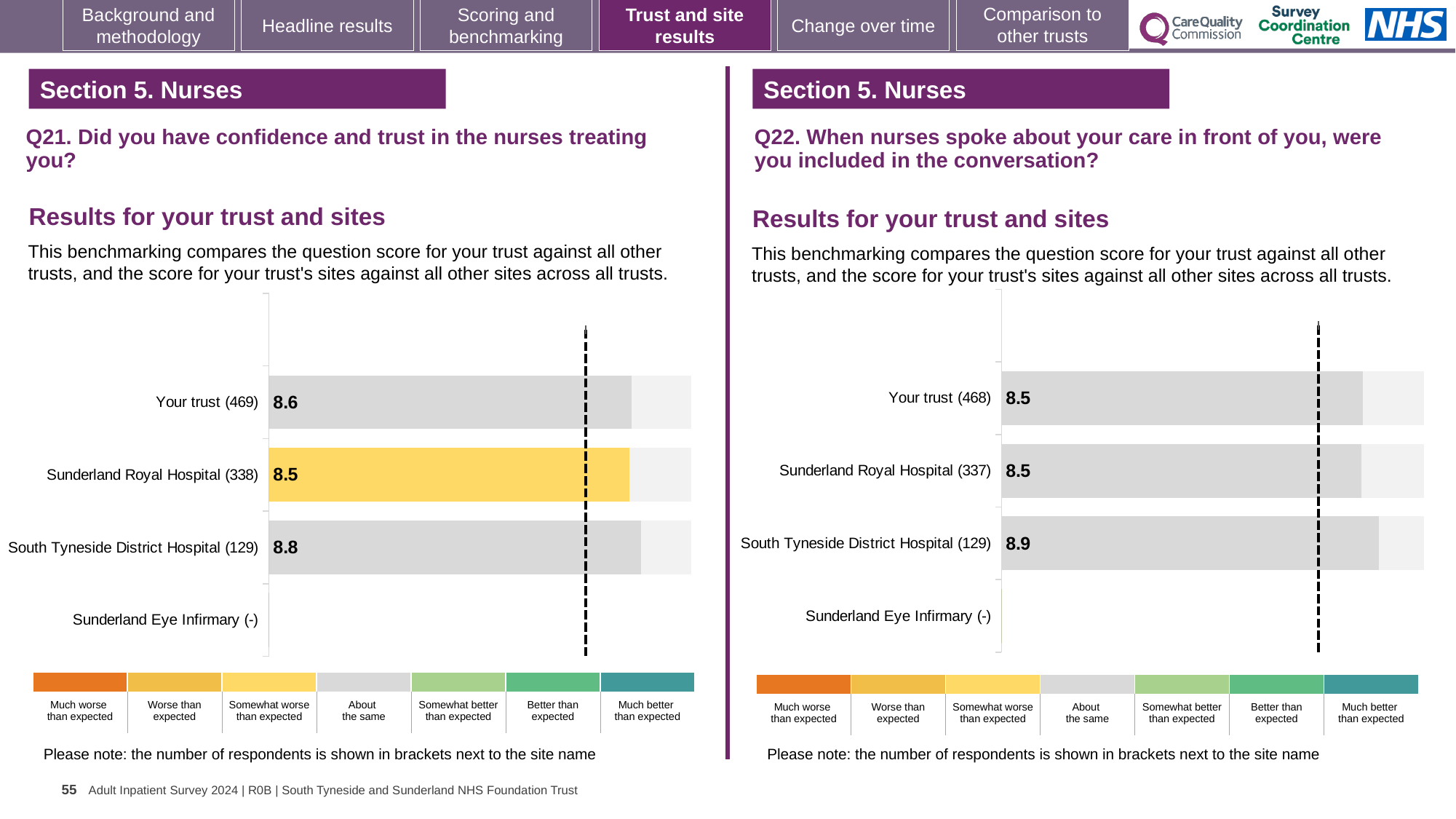
How many site/trust rows are listed on the Q21 chart on the left? 4 In the Q22 chart on the right, which is larger: the score for South Tyneside District Hospital or the score for Sunderland Royal Hospital? South Tyneside District Hospital What kind of chart is used on the Q22 chart on the right? Bar chart In the Q21 chart on the left, which bar is coloured yellow? Sunderland Royal Hospital (338) In the Q21 chart on the left, what is the difference between the scores for South Tyneside District Hospital and Sunderland Royal Hospital? 0.3 In the Q21 chart on the left, which site has the highest score? South Tyneside District Hospital (129) In the Q21 chart on the left, what is the score for Sunderland Royal Hospital (338)? 8.5 In the Q22 chart on the right, what is the score for South Tyneside District Hospital (129)? 8.9 In the Q21 chart on the left, what is the score for Your trust (469)? 8.6 In the Q22 chart on the right, what is the score for Your trust (468)? 8.5 In the Q22 chart on the right, which site has the highest score? South Tyneside District Hospital (129) In the Q22 chart on the right, what is the difference between the scores for South Tyneside District Hospital and Your trust? 0.4